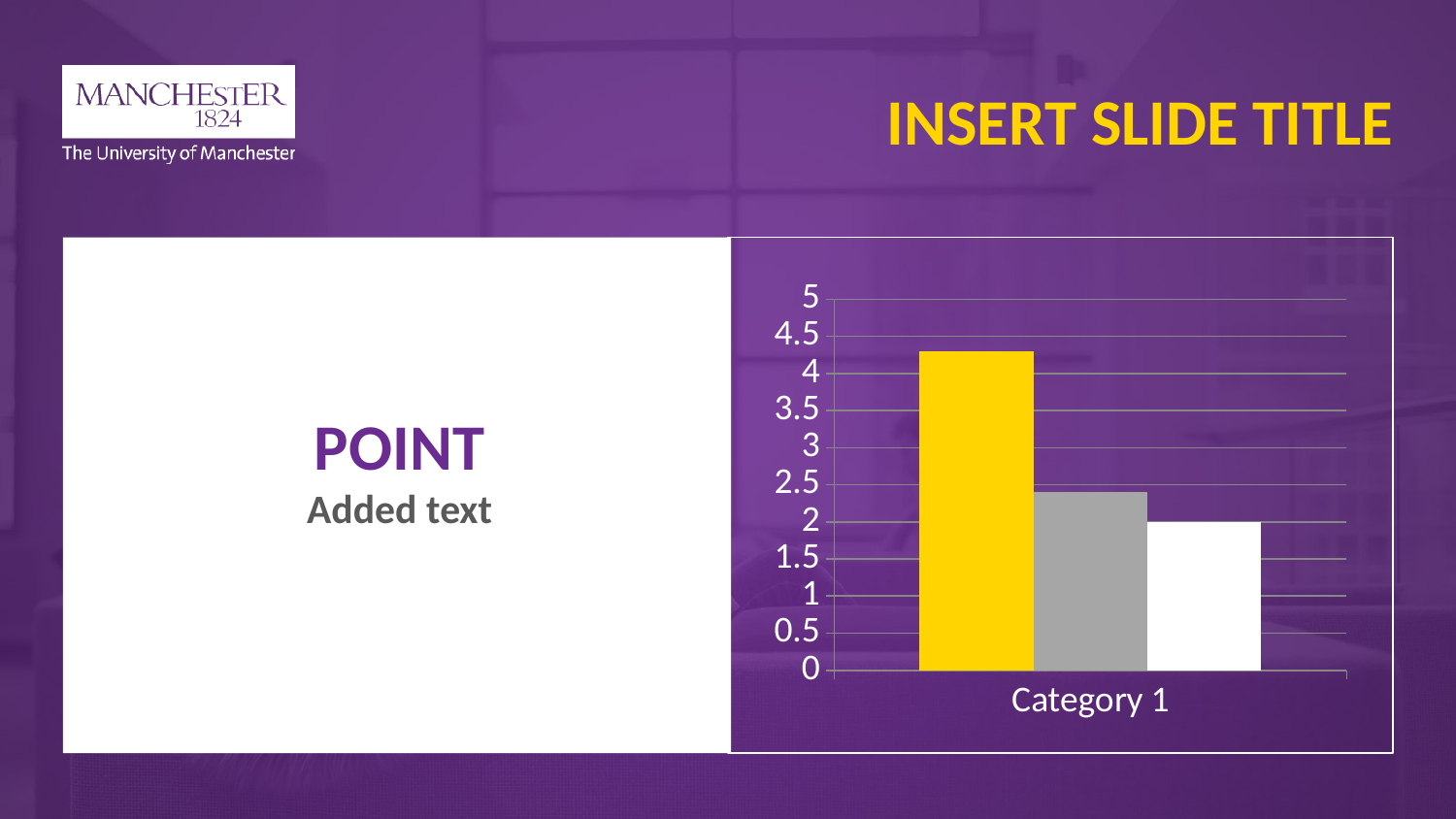
Is the value of the yellow bar greater or less than 4? greater Which is larger, the value of the grey bar or the value of the white bar? grey bar Which bar is the tallest in the chart: the yellow, grey or white bar? yellow Which bar is the shortest in the chart: the yellow, grey or white bar? white What is the highest value shown on the vertical axis of the chart? 5 What kind of chart is shown on the slide? bar chart What is the label of the category on the x axis? Category 1 How many categories are shown on the x axis of the chart? 1 How many bars are plotted for Category 1? 3 Is the value of the yellow bar greater or less than 4.5? less Is the value of the grey bar greater or less than 3? less